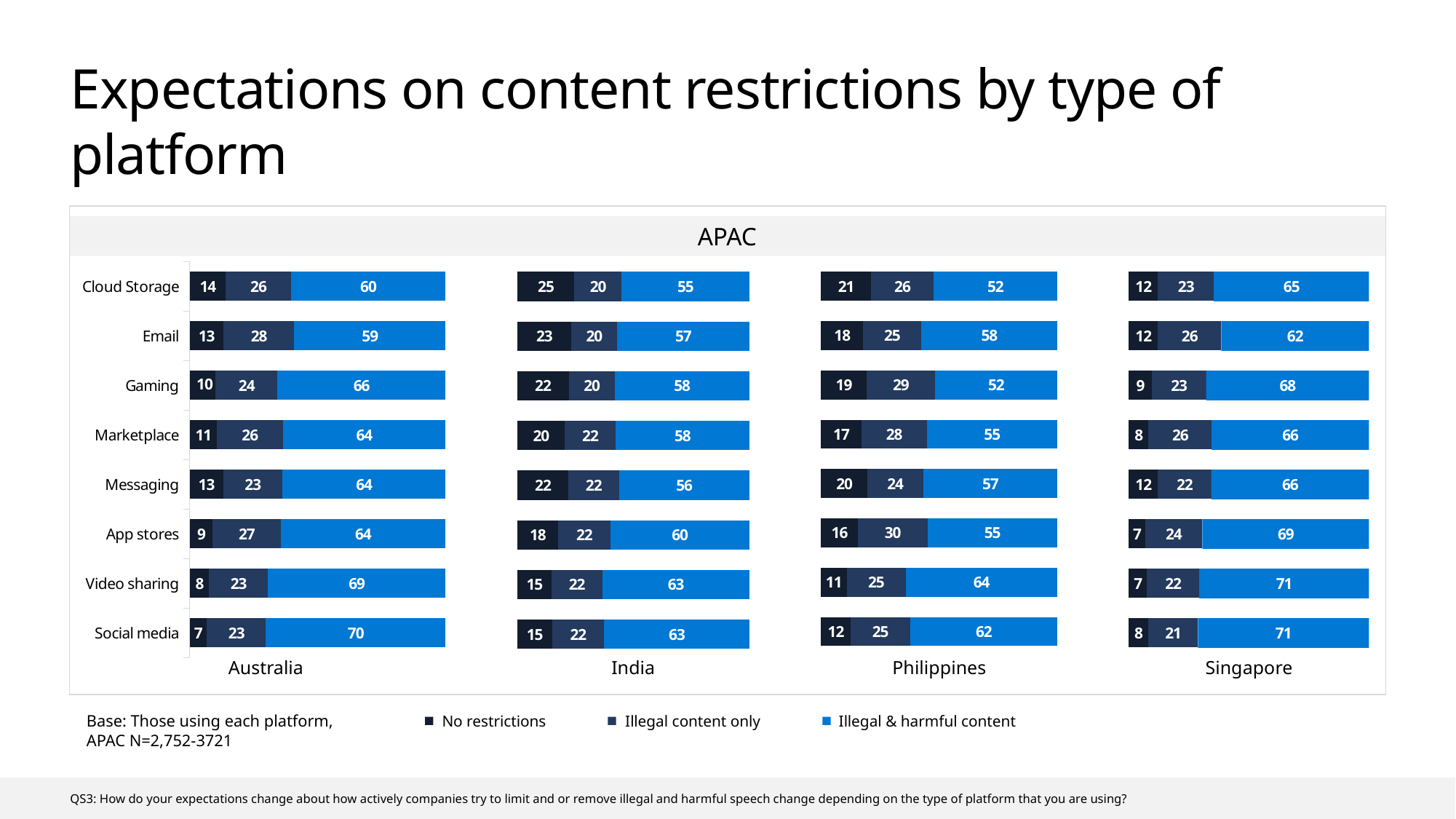
In the Australia chart, what is the total of the Cloud Storage bar? 100 In the Australia chart, what is the value for Illegal & harmful content for Gaming? 66 In the Australia chart, which platform has the lowest No restrictions value? Social media In the Singapore chart, what is the Illegal content only value for Email? 26 In the Philippines chart, what is the difference between the Illegal content only values for App stores and Cloud Storage? 4 In the Philippines chart, which platform has the highest Illegal & harmful content value? Video sharing What kind of chart is used for each country? Stacked bar chart How many series does the legend list? 3 How many platform categories are shown in each country chart? 8 In the India chart, what is the No restrictions value for Cloud Storage? 25 In the India chart, which has the larger Illegal & harmful content value, Video sharing or Cloud Storage? Video sharing In the India chart, which platform has the highest No restrictions value? Cloud Storage